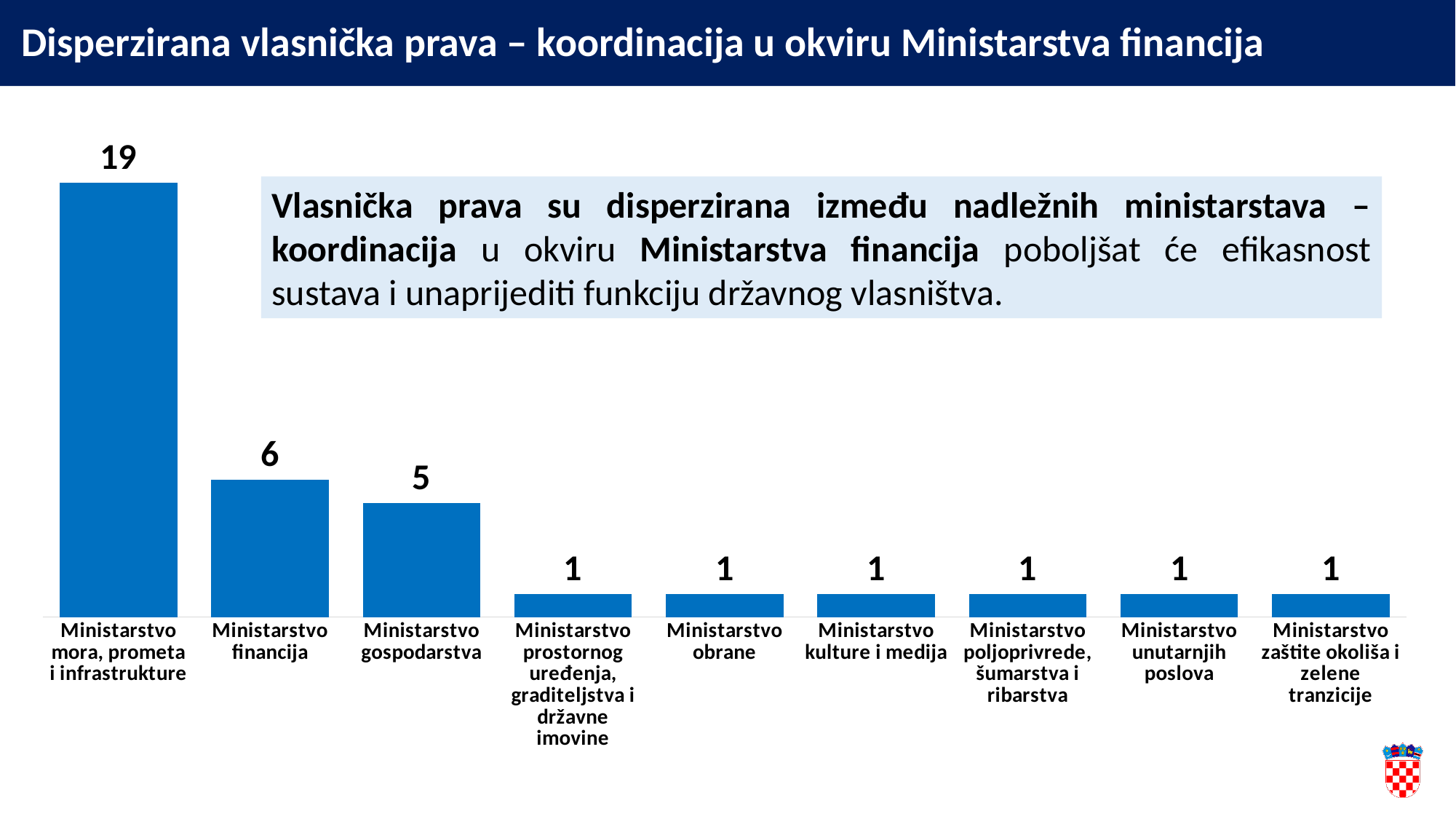
Which category has the highest value? Ministarstvo mora, prometa i infrastrukture What is the value for Ministarstvo gospodarstva? 5 How many categories are shown in the chart? 9 Which is larger, the value for Ministarstvo financija or the value for Ministarstvo gospodarstva? Ministarstvo financija What is the value for Ministarstvo financija? 6 How many categories have a value of 1? 6 What kind of chart is shown on the slide? Bar chart What is the difference between the values for Ministarstvo financija and Ministarstvo gospodarstva? 1 What is the value for Ministarstvo mora, prometa i infrastrukture? 19 Do the values rise or fall from left to right along the x axis? Fall What is the value for Ministarstvo obrane? 1 What is the difference between the values for Ministarstvo mora, prometa i infrastrukture and Ministarstvo financija? 13